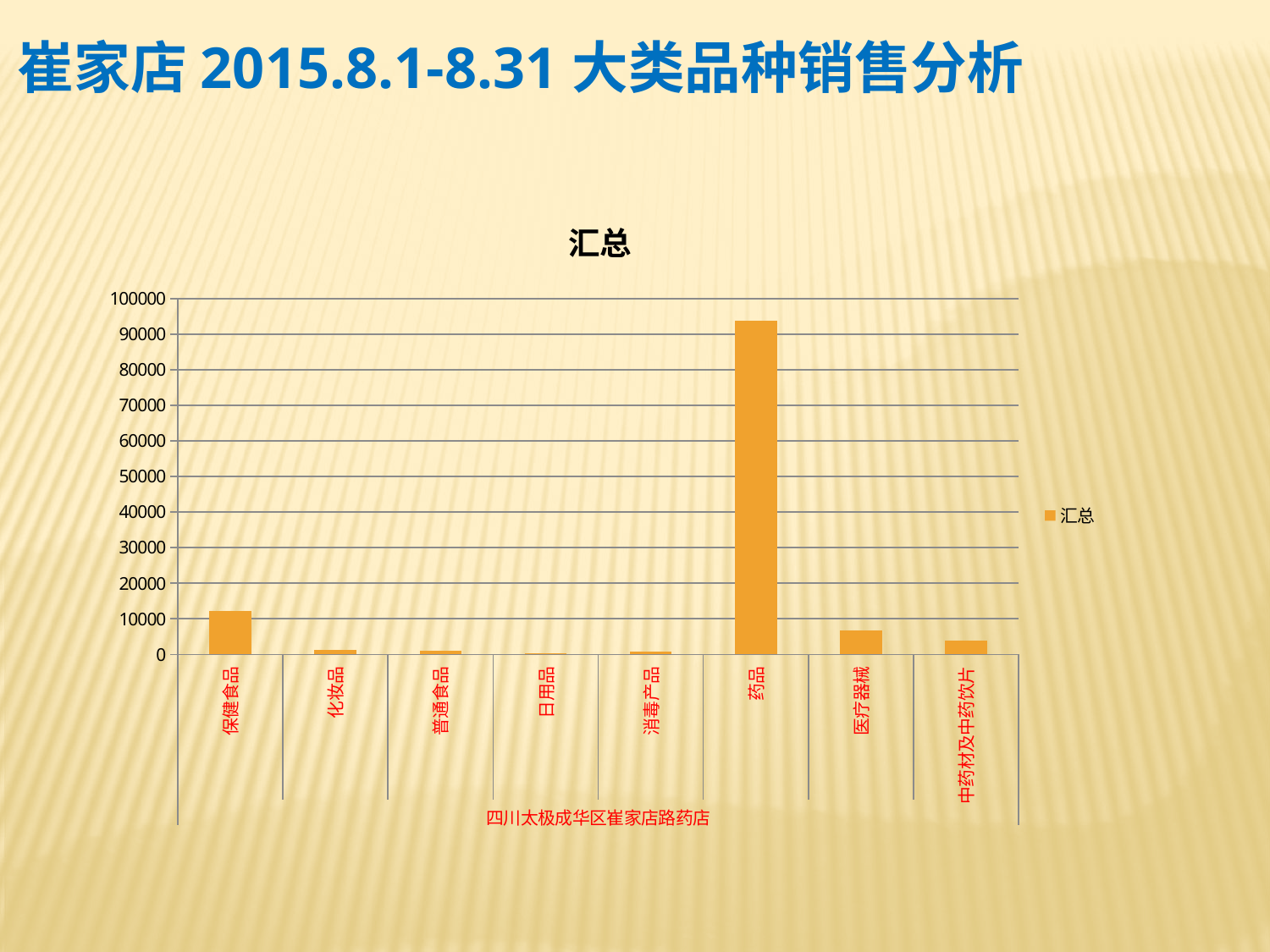
How many categories are plotted on the x axis of the chart? 8 How many series does the chart's legend list? 1 What is the title of the chart? 汇总 Is the value for 药品 greater or less than 90000? greater What kind of chart is shown on the slide? bar chart Is the value for 保健食品 greater or less than 20000? less Which is larger, the value for 保健食品 or the value for 医疗器械? 保健食品 Which category has the highest value in the chart? 药品 What is the name of the series shown in the chart's legend? 汇总 Is the value for 中药材及中药饮片 greater or less than 10000? less Which is larger, the value for 药品 or the value for 保健食品? 药品